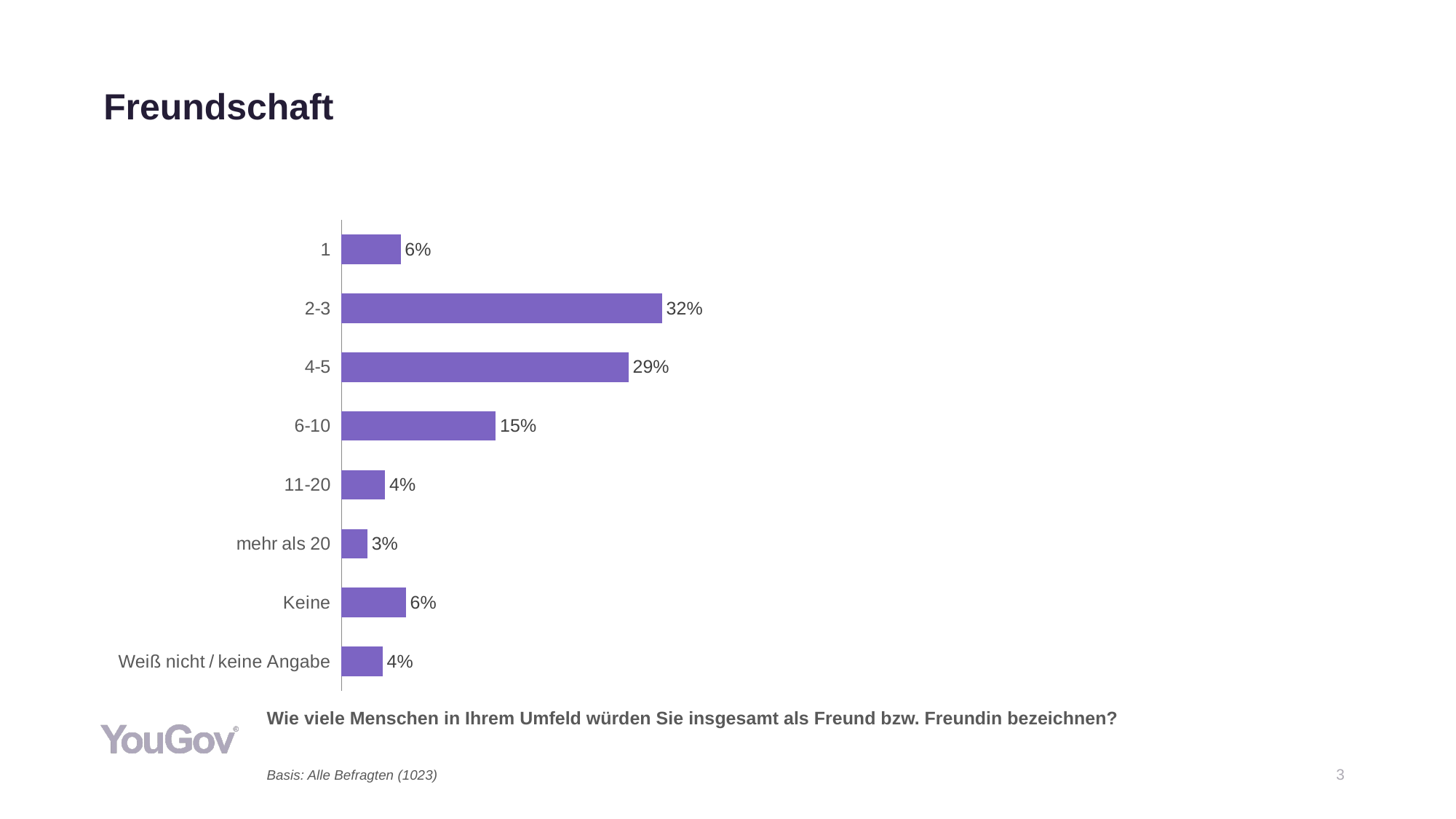
What is the title of the slide? Freundschaft What is the difference between the values for '2-3' and '4-5'? 3% Which category has the lowest value? mehr als 20 What is the value shown for the '6-10' category? 15% What is the difference between the values for '6-10' and '11-20'? 11% Which category has the highest value? 2-3 How many categories are shown in the chart? 8 What percentage is shown for 'mehr als 20'? 3% What type of chart is shown on the slide? bar chart What percentage of respondents said they have 2-3 friends? 32% What is the value for 'Weiß nicht / keine Angabe'? 4% Which is larger, the value for '1' or the value for 'mehr als 20'? 1